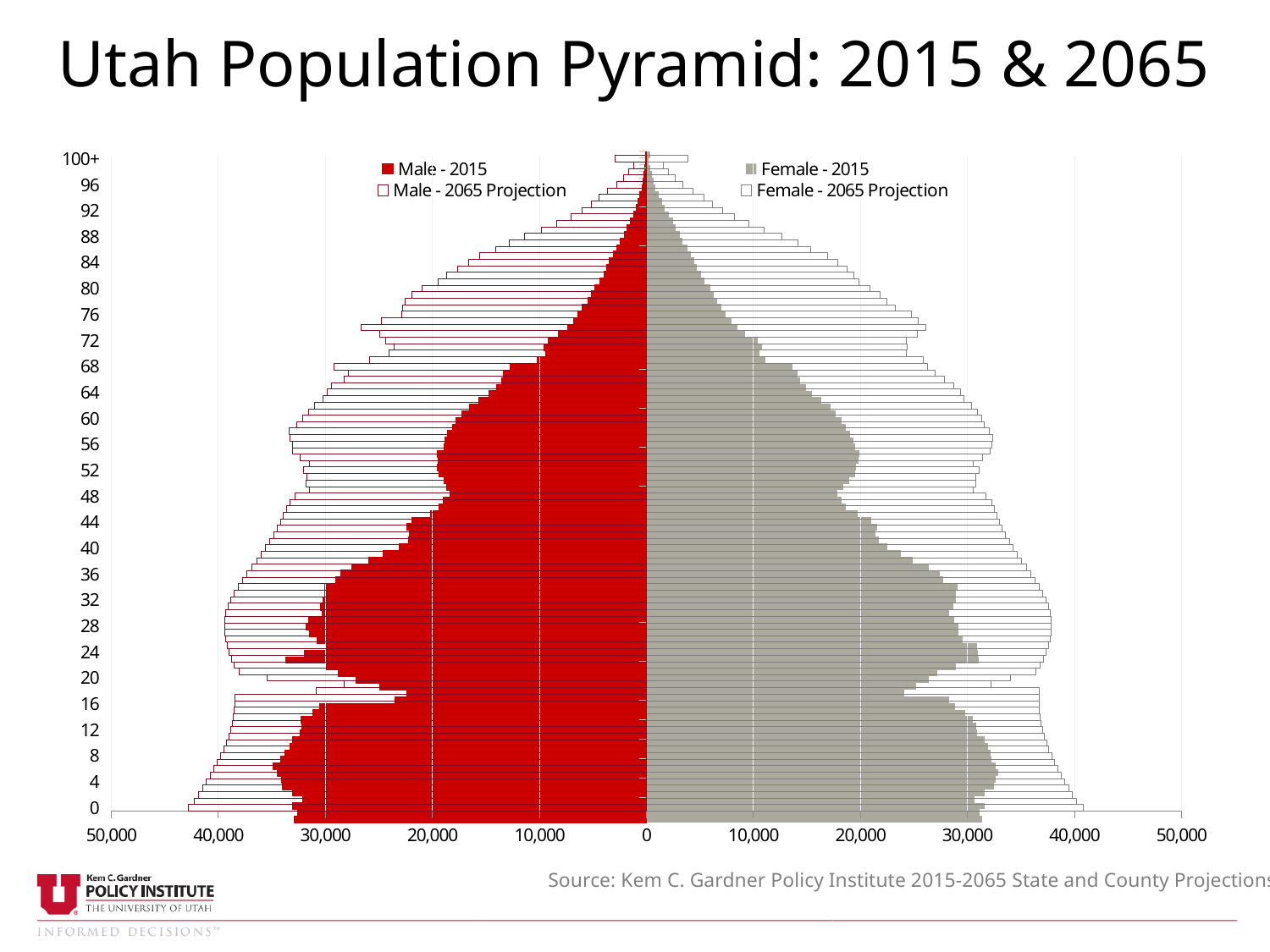
How many series does the legend list? 4 Is the Female - 2065 Projection value at age 28 greater or less than 30,000? greater Is the Male - 2065 Projection value at age 28 greater or less than 30,000? greater Which is larger for Male - 2015: the value at age 0 or the value at age 80? Age 0 At age 28, which is larger: Male - 2015 or Male - 2065 Projection? Male - 2065 Projection What kind of chart is shown on the slide? Bar chart (population pyramid) Is the Female - 2015 value at age 80 greater or less than 10,000? less For Female - 2015, do the values rise or fall as age increases from 60 to 100+? Fall What is the title of the chart? Utah Population Pyramid: 2015 & 2065 Which series is drawn in solid red? Male - 2015